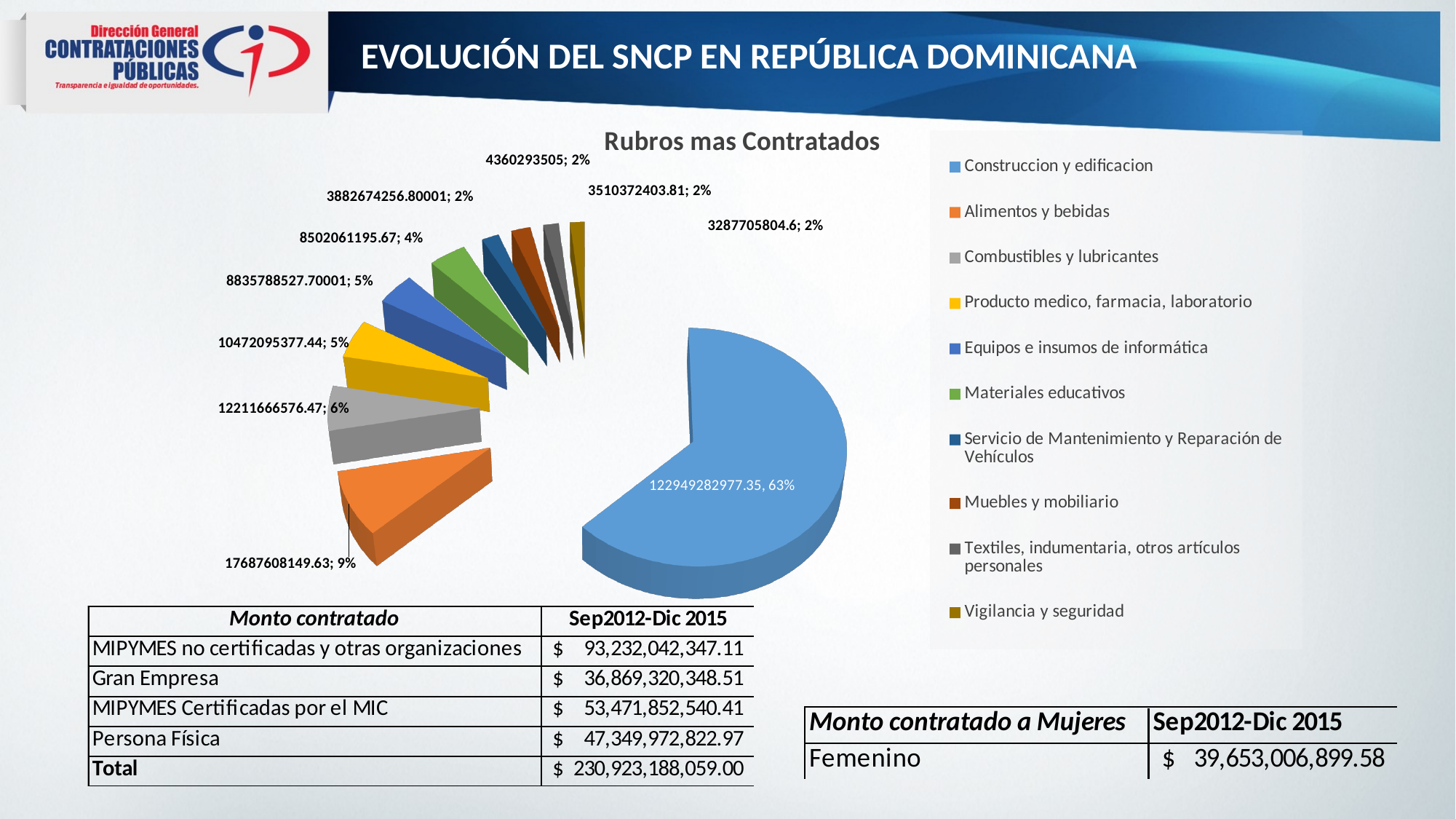
What kind of chart is 'Rubros mas Contratados'? pie chart What share of the 'Rubros mas Contratados' pie does Alimentos y bebidas represent? 9% What share of the 'Rubros mas Contratados' pie does Construccion y edificacion represent? 63% In the 'Rubros mas Contratados' chart, which is larger: Alimentos y bebidas or Combustibles y lubricantes? Alimentos y bebidas What is the value shown for Combustibles y lubricantes in the 'Rubros mas Contratados' chart? 12211666576.47 What colour is the Construccion y edificacion slice in the 'Rubros mas Contratados' chart? blue Which category has the largest slice in the 'Rubros mas Contratados' pie chart? Construccion y edificacion How many categories does the legend of the 'Rubros mas Contratados' chart list? 10 What share of the 'Rubros mas Contratados' pie does Materiales educativos represent? 4% What is the title of the pie chart on the slide? Rubros mas Contratados In the 'Rubros mas Contratados' chart, what is the difference between the values for Alimentos y bebidas and Combustibles y lubricantes? 5475941573.16 What is the value shown for Construccion y edificacion in the 'Rubros mas Contratados' chart? 122949282977.35